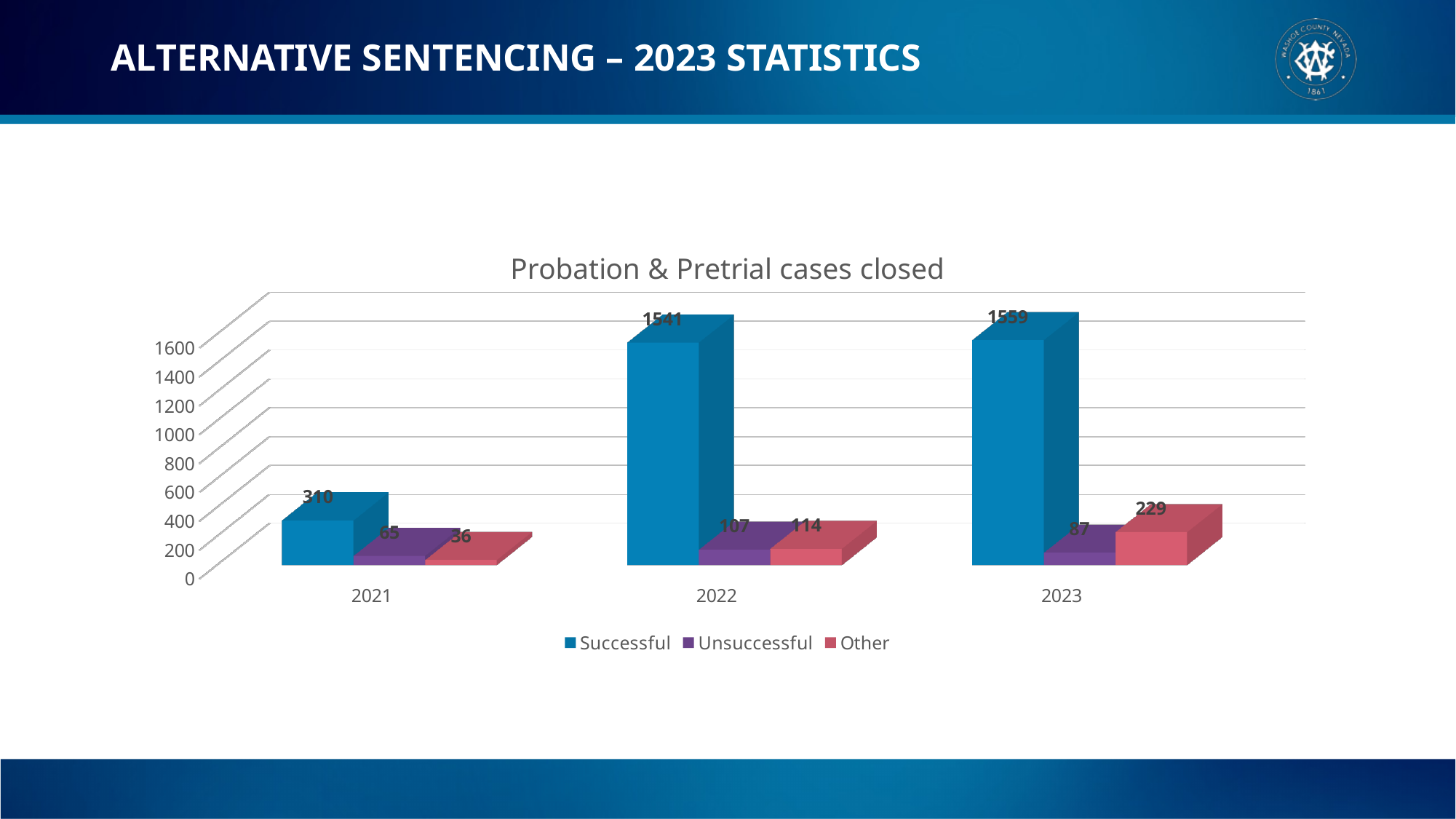
How many years are shown on the x axis? 3 Which is larger, the Unsuccessful value for 2022 or the Unsuccessful value for 2023? 2022 What is the Unsuccessful value for 2021? 65 Does the Successful value rise or fall from 2021 to 2023? Rise What is the difference between the Successful values for 2023 and 2022? 18 What is the title of the chart? Probation & Pretrial cases closed What is the Other value for 2023? 229 Which year has the lowest Other value? 2021 What kind of chart is shown on the slide? Bar chart How many series does the legend list? 3 What is the Successful value for 2022? 1541 Which year has the highest Successful value? 2023